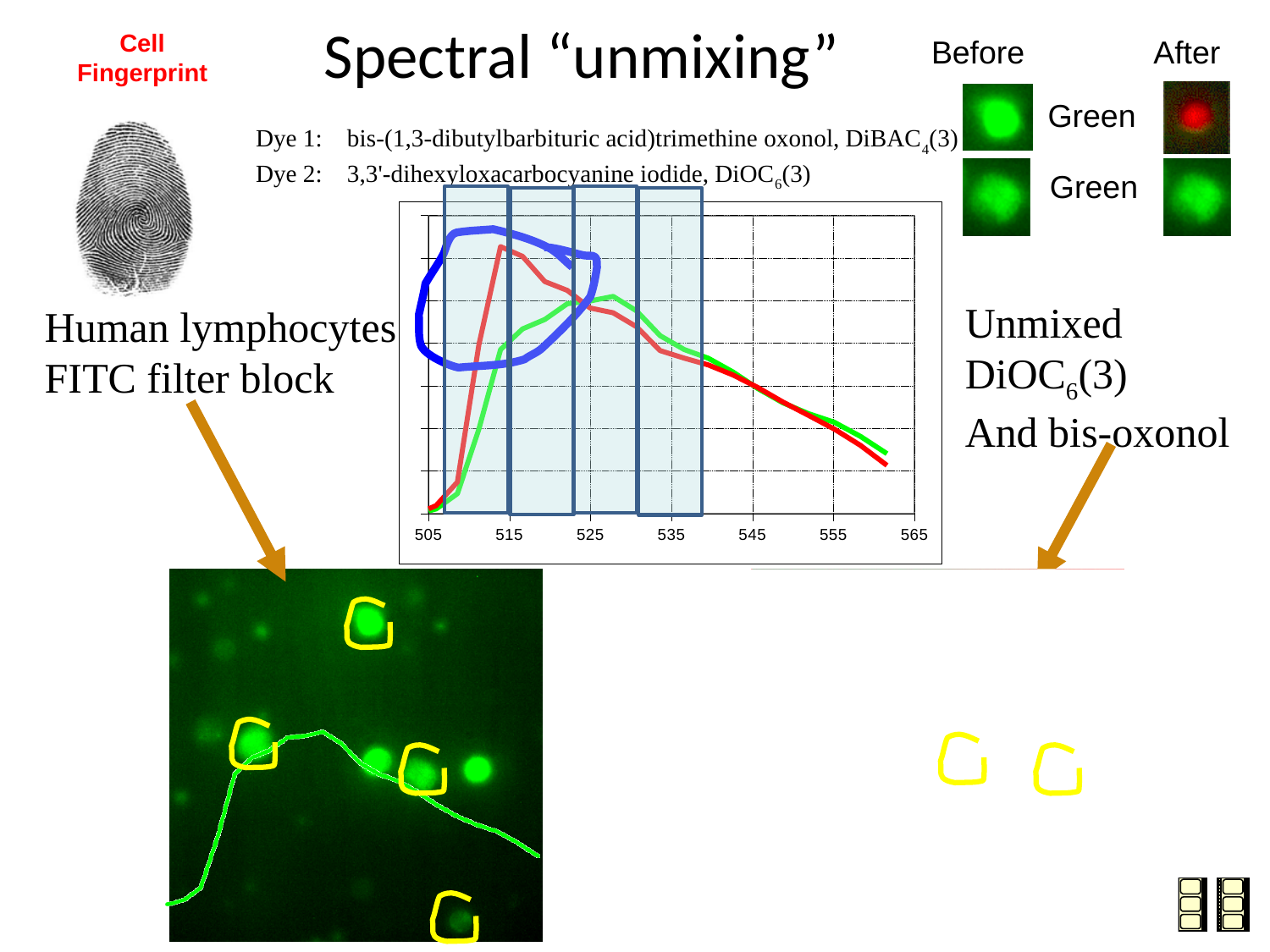
How many tick labels are shown on the x axis of the spectral chart? 7 How many lines (series) are plotted on the spectral chart? 2 Is the peak of the red line on the spectral chart at a wavelength greater or less than 525? less At x = 530, which line is higher on the spectral chart, the red or the green? green What kind of chart is shown in the centre of the slide? line chart How many shaded vertical bands are overlaid on the spectral chart? 4 Do the two lines on the spectral chart rise or fall between x = 535 and x = 565? fall Is the peak of the green line on the spectral chart at a wavelength greater or less than 535? less What is the lowest x-axis tick label on the spectral chart? 505 What colours are the two lines plotted on the spectral chart? red and green What is the highest x-axis tick label on the spectral chart? 565 At x = 515, which line is higher on the spectral chart, the red or the green? red